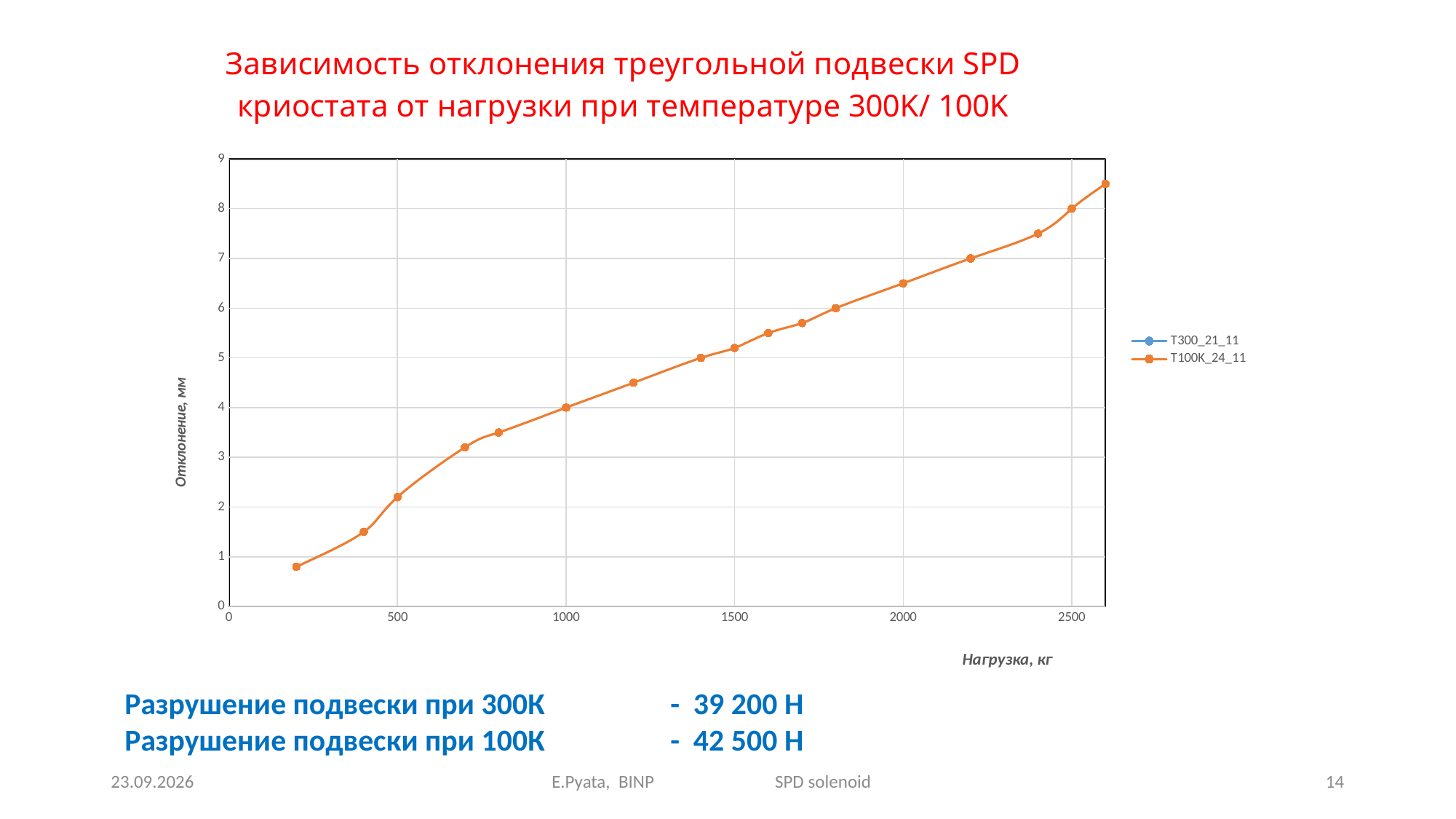
What is the label of the vertical axis? Отклонение, мм Is the highest plotted deflection greater or less than 8 mm? greater What is the deflection (mm) at a load of 1000 kg? 4 What are the two series names listed in the legend? T300_21_11 and T100K_24_11 Which load has the larger deflection, 1500 kg or 2200 kg? 2200 kg Is the lowest plotted deflection greater or less than 1 mm? less What kind of chart is shown on the slide? line chart How many series does the legend list? 2 Does the deflection rise or fall as the load increases along the x axis? rises Is the deflection at a load of 500 kg greater or less than 3 mm? less What is the deflection (mm) at a load of 2500 kg? 8